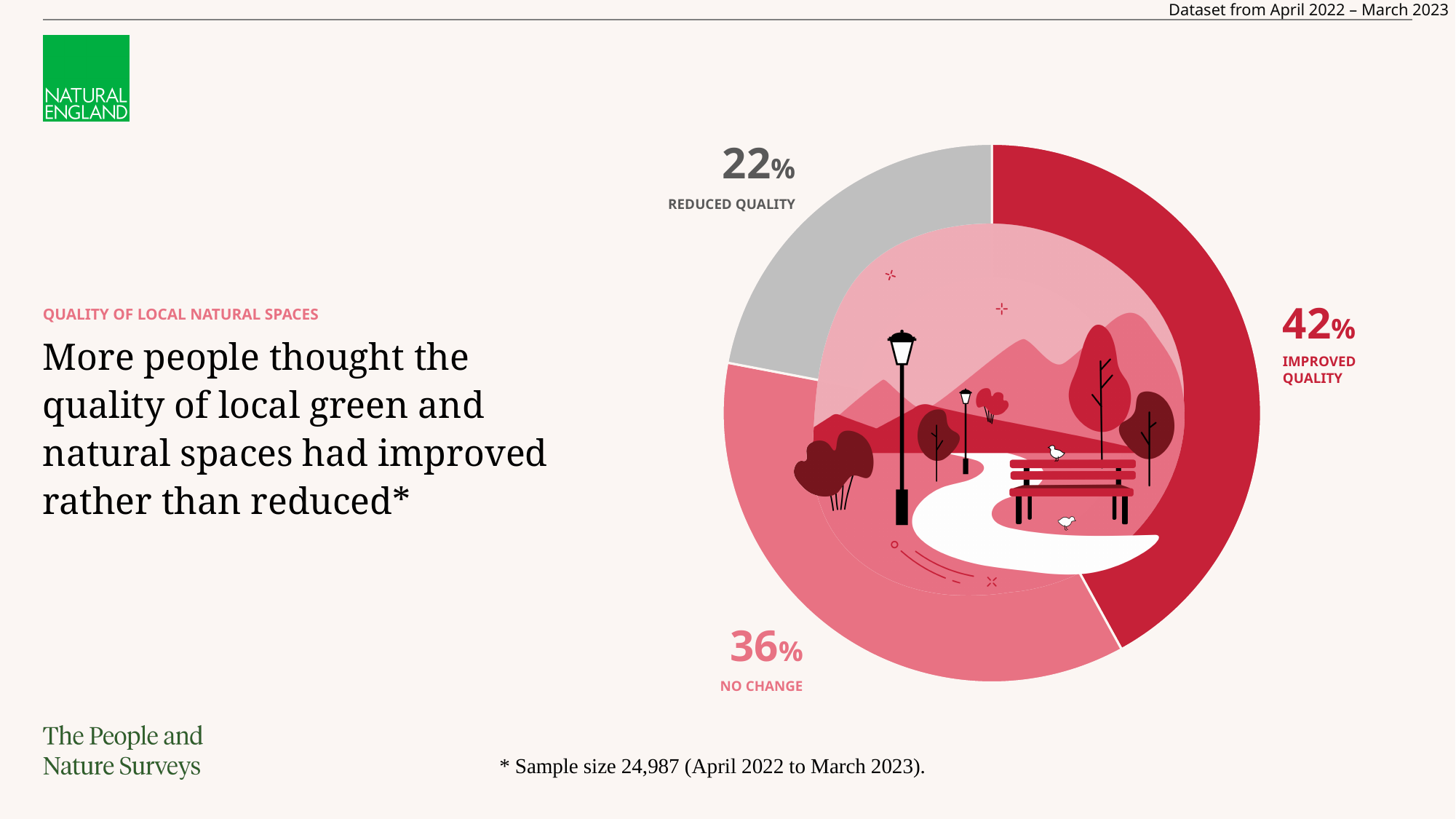
What percentage of respondents said the quality of local natural spaces had improved? 42% What percentage of respondents reported no change in the quality of local natural spaces? 36% Which is larger: the share for 'No change' or the share for 'Reduced quality'? No change Which category has the largest share of the chart? Improved quality Which category has the smallest share of the chart? Reduced quality How many categories are shown in the chart? 3 What is the difference in percentage points between 'Improved quality' and 'Reduced quality'? 20 What kind of chart is shown on the slide? Pie chart (donut) What colour is the 'Reduced quality' segment of the chart? Grey What percentage of respondents reported reduced quality of local natural spaces? 22% What is the sample size stated in the footnote? 24,987 What is the difference in percentage points between 'Improved quality' and 'No change'? 6